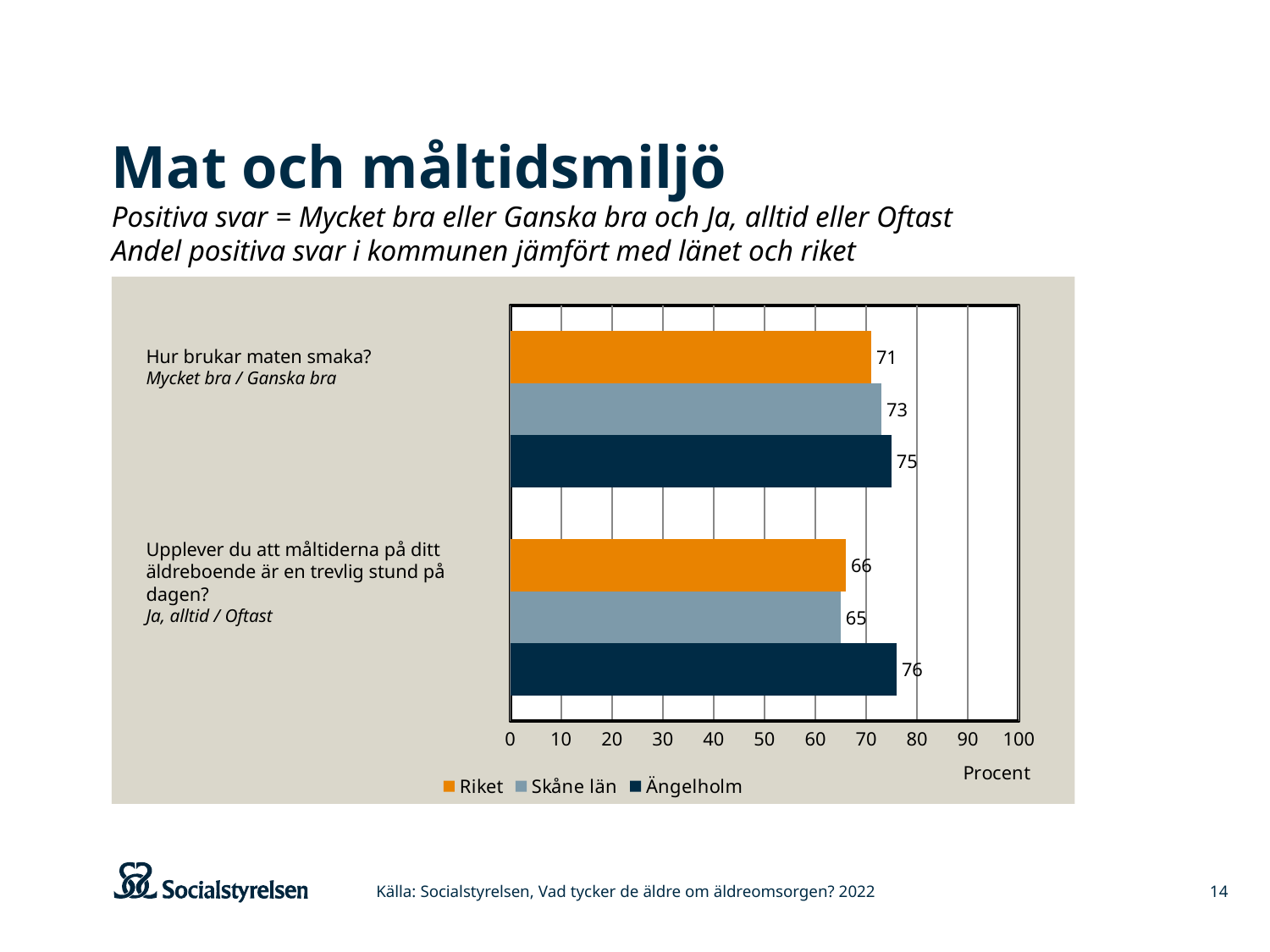
What is the difference between Ängelholm and Skåne län on the question "Upplever du att måltiderna på ditt äldreboende är en trevlig stund på dagen?"? 11 What is the value for Riket on the question "Hur brukar maten smaka?"? 71 What is the value for Ängelholm on the question "Upplever du att måltiderna på ditt äldreboende är en trevlig stund på dagen?"? 76 How many series does the legend list? 3 What is the value for Ängelholm on the question "Hur brukar maten smaka?"? 75 Which series has the highest value on the question "Upplever du att måltiderna på ditt äldreboende är en trevlig stund på dagen?"? Ängelholm Is the value for Riket on "Upplever du att måltiderna på ditt äldreboende är en trevlig stund på dagen?" greater or less than 70? less Which series has the lowest value on the question "Hur brukar maten smaka?"? Riket What unit is shown on the horizontal axis of the chart? Procent What is the difference between Ängelholm and Riket on the question "Hur brukar maten smaka?"? 4 What kind of chart is shown on the slide? Bar chart What is the value for Skåne län on the question "Upplever du att måltiderna på ditt äldreboende är en trevlig stund på dagen?"? 65